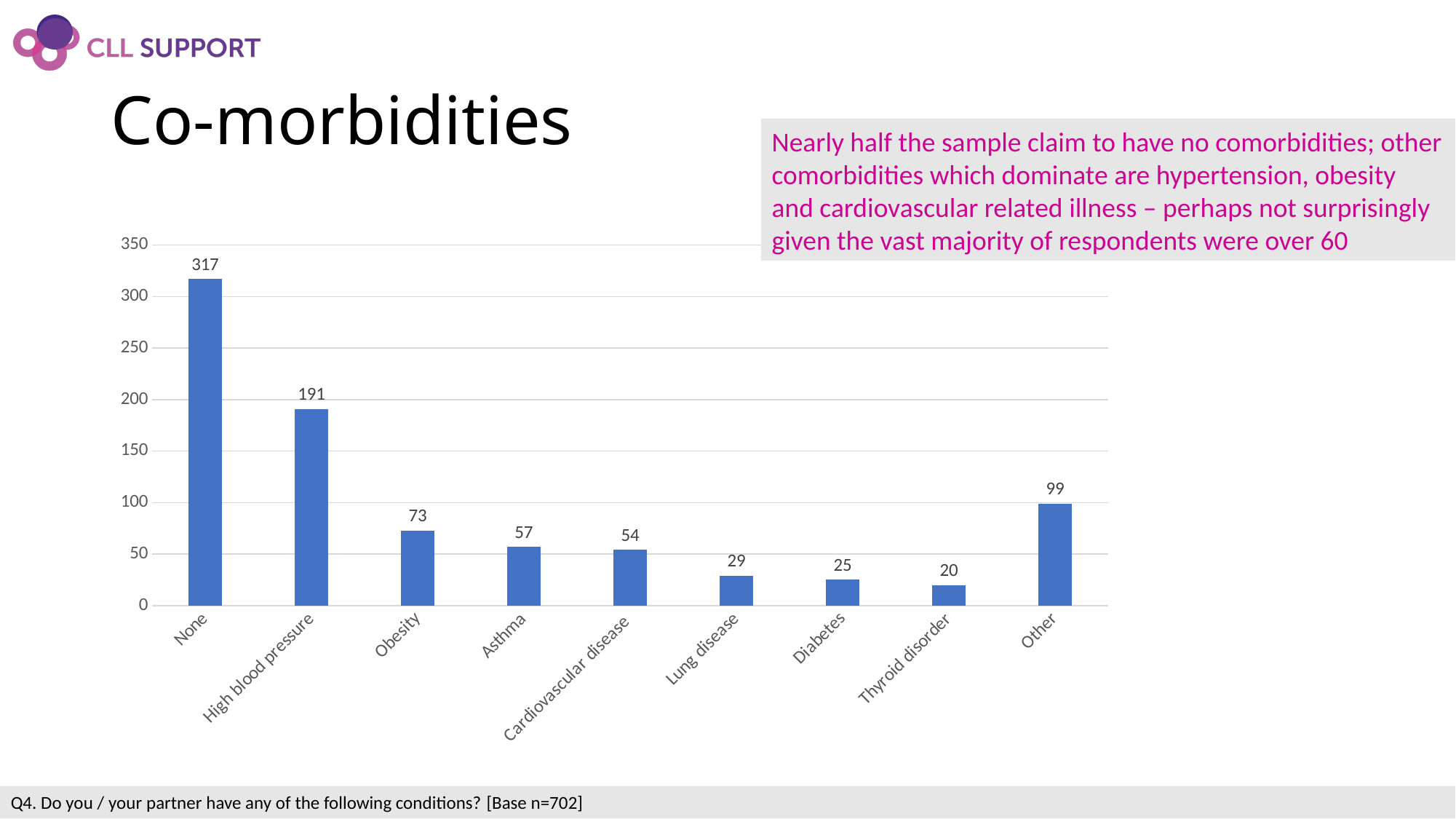
Which category has the lowest value? Thyroid disorder What is the value for Thyroid disorder? 20 Which is larger, the value for Lung disease or the value for Diabetes? Lung disease What is the difference between the values for None and High blood pressure? 126 What is the value for Other? 99 What is the value for High blood pressure? 191 What kind of chart is shown on the slide? bar chart Is the value for Other greater or less than 150? less What is the value for Obesity? 73 What is the difference between the values for Asthma and Cardiovascular disease? 3 Which category has the highest value? None How many categories are shown on the x axis? 9